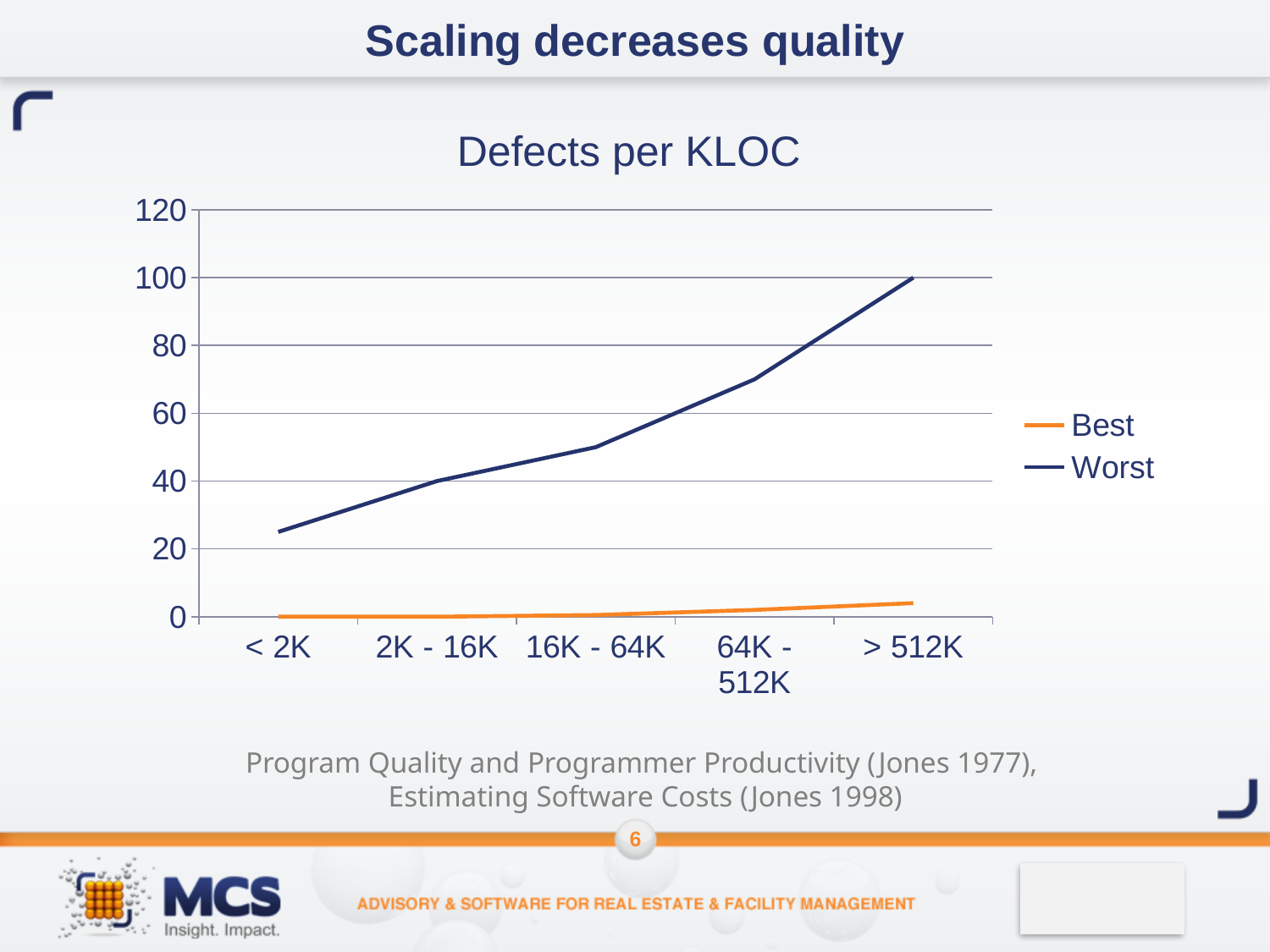
For the Worst series, which category has the highest value? > 512K Does the Worst series rise or fall as program size increases along the x axis? rise How many categories are shown on the x axis? 5 What kind of chart is shown on the slide? line chart Is the Worst value for 64K - 512K greater or less than 60? greater For the Worst series, which category has the lowest value? < 2K What is the title of the chart? Defects per KLOC Which series is shown in orange? Best Is the Best value for > 512K greater or less than 20? less How many series does the legend list? 2 Is the Worst value for < 2K greater or less than 40? less Which series has the higher value at > 512K, Best or Worst? Worst